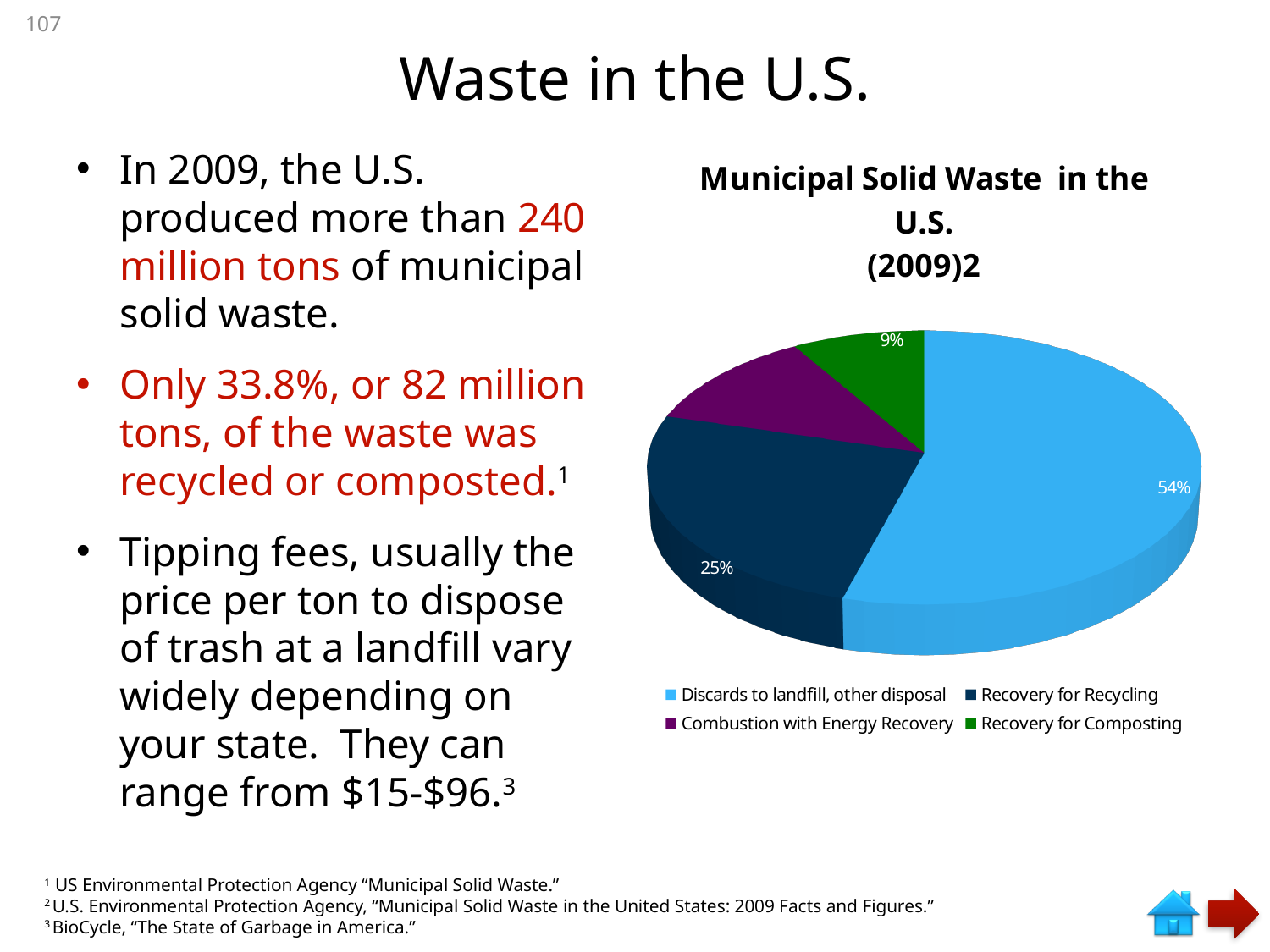
What percentage is shown for 'Recovery for Composting'? 9% How many categories does the pie chart legend list? 4 Which is larger, 'Recovery for Recycling' or 'Recovery for Composting'? Recovery for Recycling What is the difference in percentage points between 'Discards to landfill, other disposal' and 'Recovery for Recycling'? 29 percentage points What is the difference in percentage points between 'Recovery for Recycling' and 'Recovery for Composting'? 16 percentage points Which category has the largest slice of the pie? Discards to landfill, other disposal What percentage is shown for 'Recovery for Recycling'? 25% What share of the pie does 'Recovery for Recycling' represent? 25% What percentage of municipal solid waste is labelled as 'Discards to landfill, other disposal'? 54% What is the title of the pie chart? Municipal Solid Waste in the U.S. (2009)2 What kind of chart is shown on the slide? Pie chart What colour represents 'Recovery for Composting' in the pie chart? Green